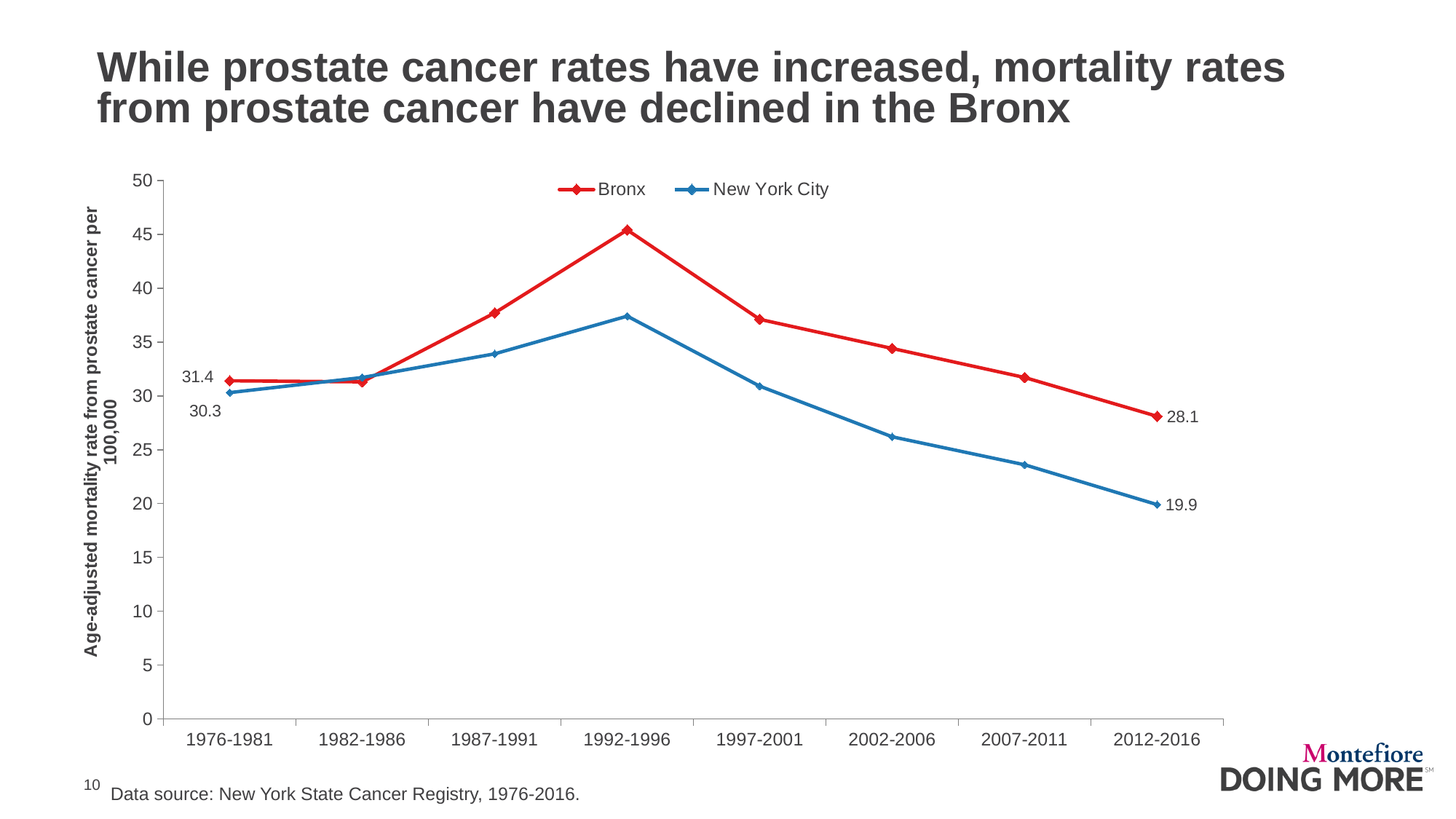
By how much did the Bronx mortality rate fall from 1976-1981 to 2012-2016? 3.3 What kind of chart is shown on the slide? Line chart In which period does the Bronx mortality rate reach its highest value? 1992-1996 In 2012-2016, which is larger: the Bronx rate or the New York City rate? Bronx What is the Bronx mortality rate for 1976-1981? 31.4 Is the Bronx value for 1992-1996 greater or less than 40? greater What is the Bronx mortality rate for 2012-2016? 28.1 How many time periods are shown on the x axis? 8 In which period is the New York City mortality rate lowest? 2012-2016 What is the difference between the Bronx and New York City mortality rates in 2012-2016? 8.2 What is the New York City mortality rate for 1976-1981? 30.3 What is the New York City mortality rate for 2012-2016? 19.9